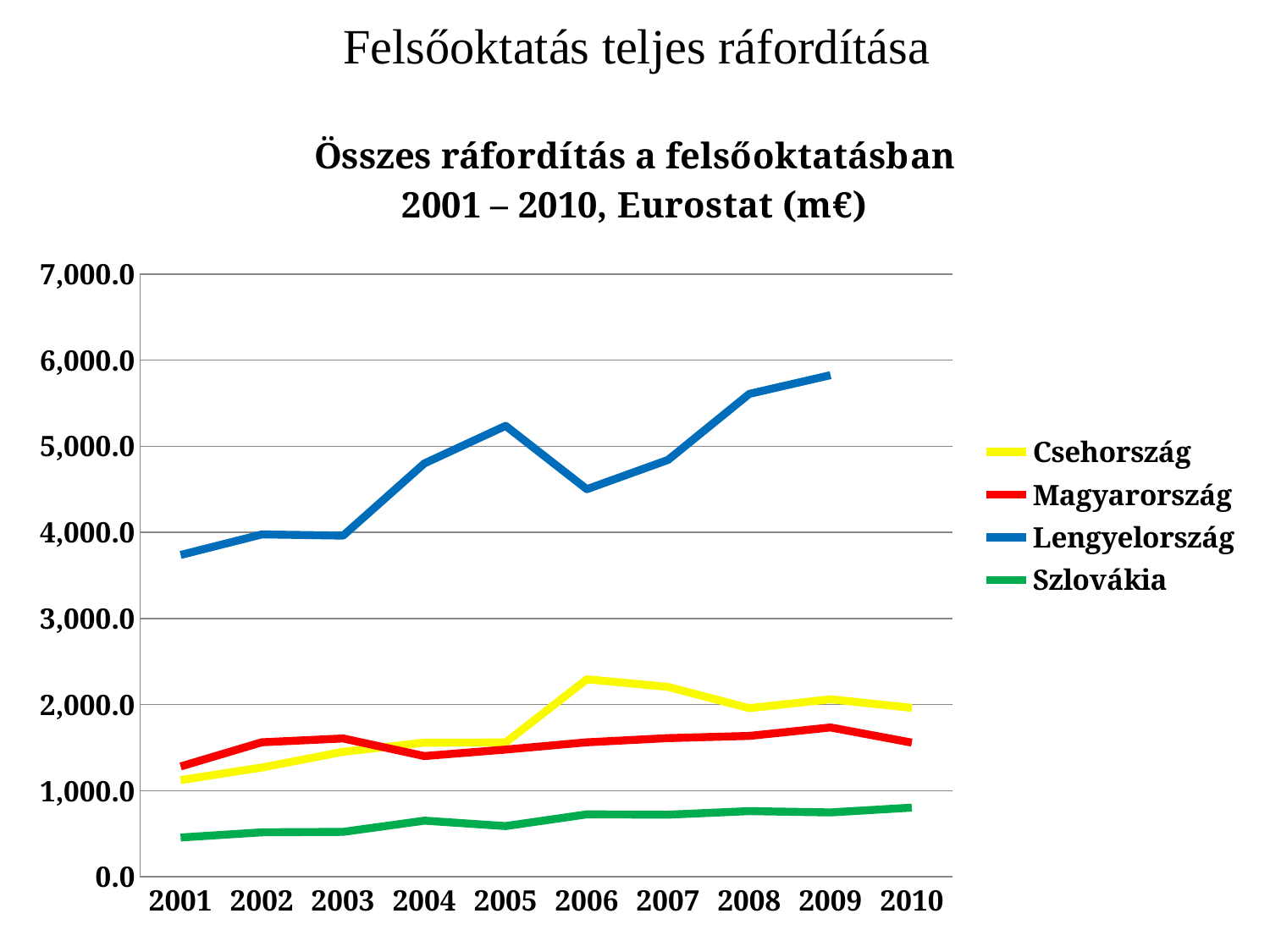
In which year does the Lengyelország line reach its highest value? 2009 Which country has the highest total expenditure across the whole period? Lengyelország Does the Lengyelország line generally rise or fall from 2001 to 2009? rise In which year does the Csehország line reach its highest value? 2006 How many years are shown on the x axis? 10 Which country has the lowest total expenditure across the whole period? Szlovákia Is the value for Csehország in 2006 greater or less than 2,000.0? greater Which is larger in 2006, the value for Csehország or the value for Magyarország? Csehország What kind of chart is shown on the slide? line chart Is the value for Lengyelország in 2001 greater or less than 4,000.0? less How many series does the legend list? 4 Is the value for Szlovákia in 2010 greater or less than 1,000.0? less